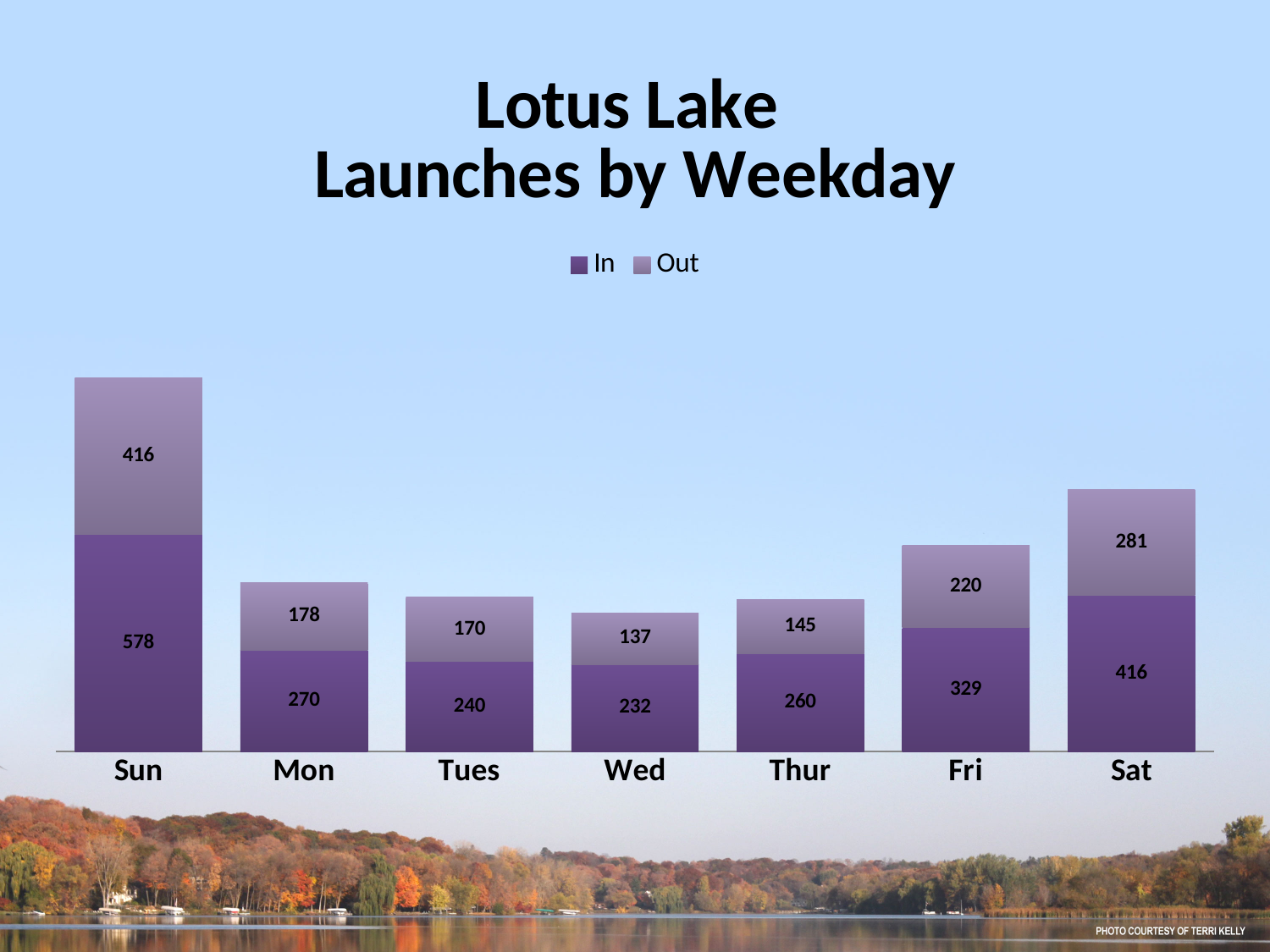
What is the difference between the 'In' values for Sat and Fri? 87 Which weekday has the lowest 'Out' value? Wed What kind of chart is shown on the slide? Stacked bar chart What is the total of the stacked bar for Thur? 405 What is the 'Out' value for Sat? 281 What is the 'In' value for Sun? 578 Which is larger, the 'Out' value for Mon or the 'Out' value for Tues? Mon What is the total of the stacked bar for Sun? 994 What is the 'In' value for Wed? 232 How many series does the legend list? 2 Which weekday has the highest 'In' value? Sun How many weekdays are shown on the x axis? 7